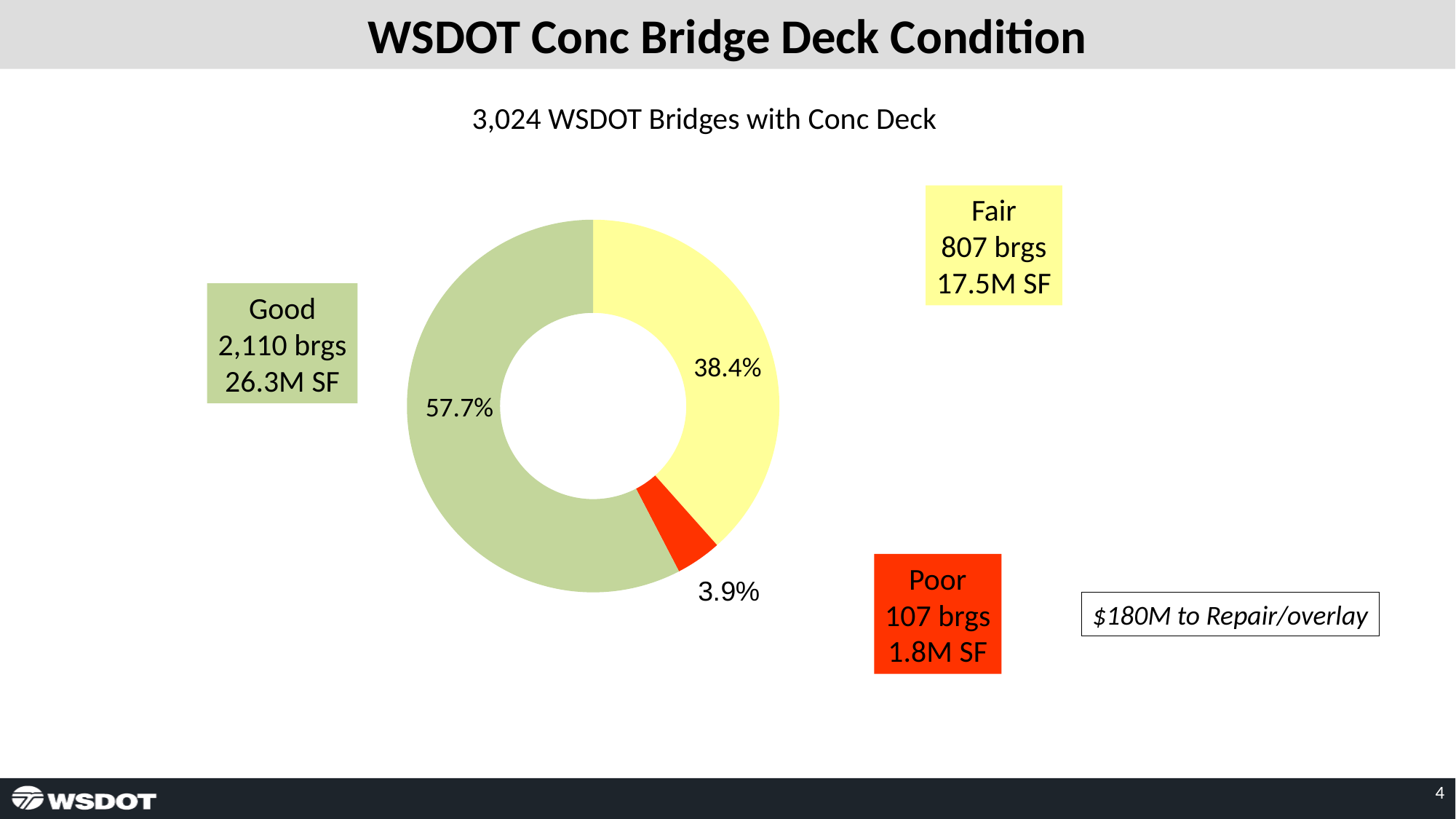
Which slice is larger, Fair or Poor? Fair Which condition category has the largest share of the chart? Good What type of chart is shown on the slide? Doughnut chart What is the chart's title? 3,024 WSDOT Bridges with Conc Deck How many bridges are in Fair condition according to the label? 807 brgs How many condition categories are shown in the doughnut chart? 3 What percentage of the doughnut chart is the Good slice? 57.7% Which condition category has the smallest share of the chart? Poor What is the difference in percentage points between the Good and Fair slices? 19.3 What percentage of the doughnut chart is the Poor slice? 3.9% What colour is the Poor slice of the doughnut chart? Red What percentage of the doughnut chart is the Fair slice? 38.4%